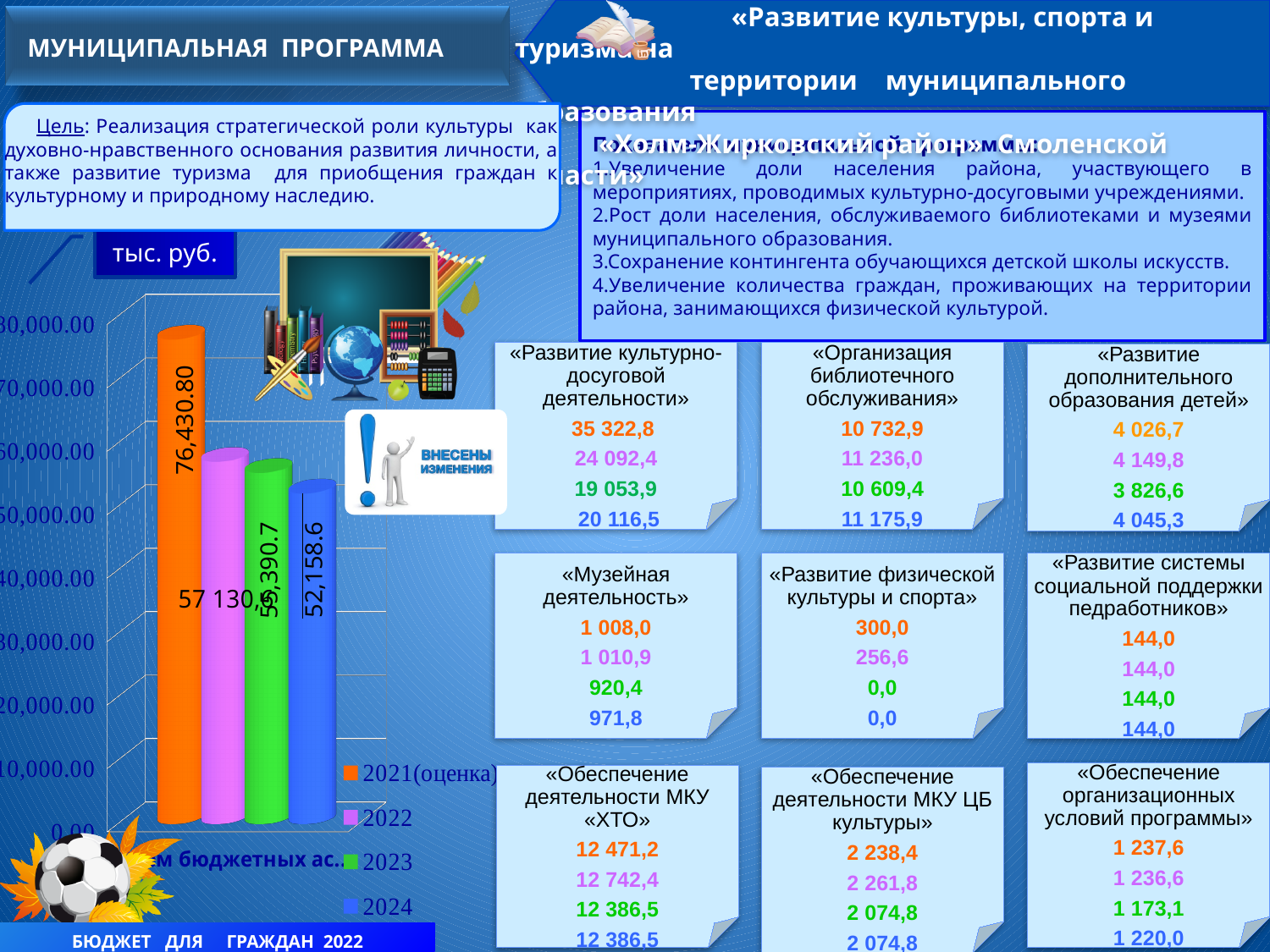
Which is larger in the bar chart, the 2022 value or the 2023 value? 2022 Which year has the lowest value in the bar chart? 2024 Which year has the highest value in the bar chart? 2021(оценка) How many series does the legend of the bar chart list? 4 What is the difference between the 2021(оценка) value and the 2024 value in the bar chart? 24,272.2 Is the value for 2021(оценка) in the bar chart greater or less than 70,000.00? greater What is the value of the 2021(оценка) bar in the bar chart? 76,430.80 Do the values in the bar chart rise or fall from 2021(оценка) to 2024? fall What kind of chart is shown on the left of the slide? bar chart What is the value of the 2024 bar in the bar chart? 52,158.6 What is the value of the 2023 bar in the bar chart? 55,390.7 What is the value of the 2022 bar in the bar chart? 57 130,9